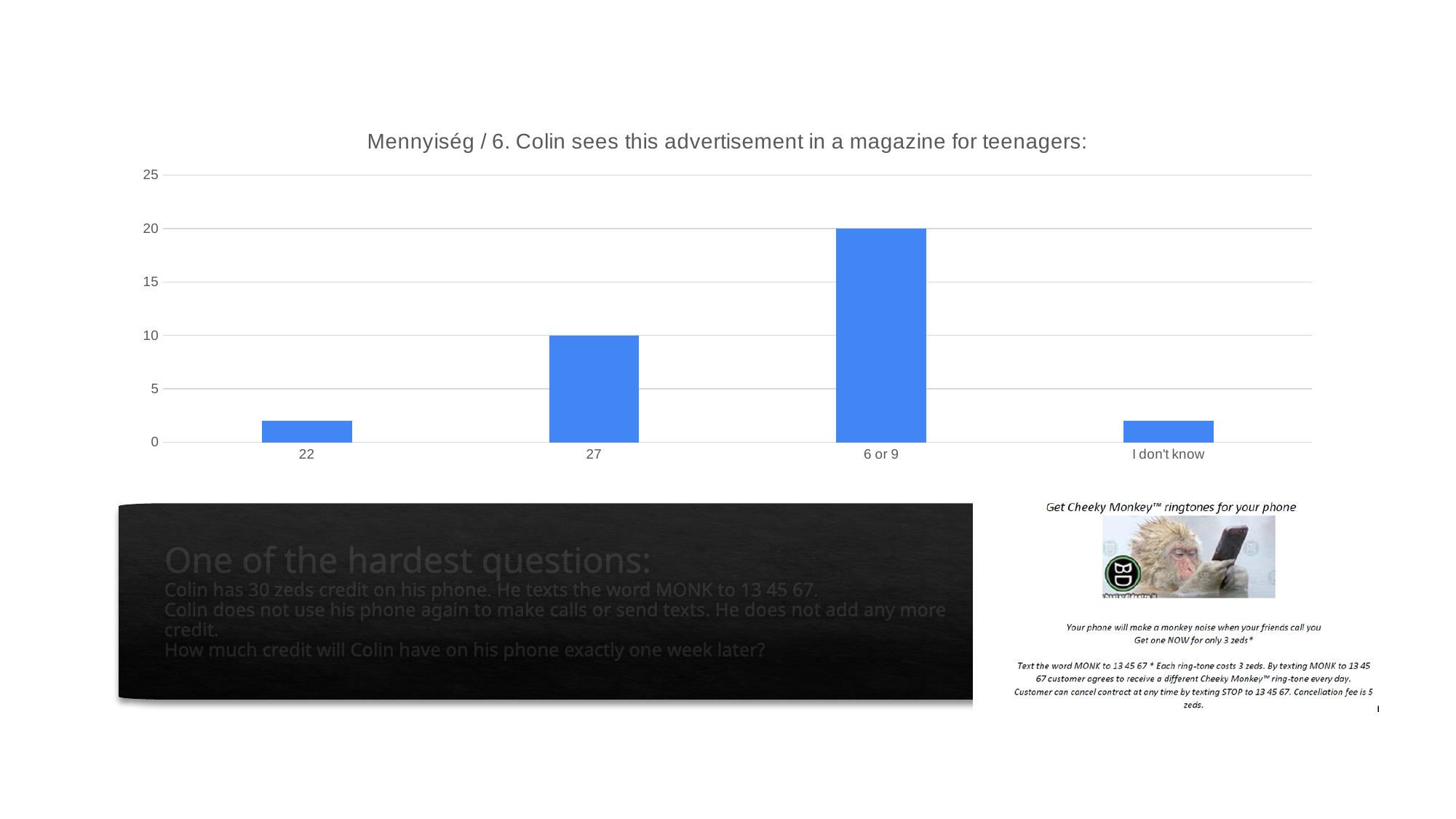
What is the value for the category "27"? 10 Which category has the highest value? 6 or 9 What kind of chart is shown on the slide? bar chart What is the title of the chart? Mennyiség / 6. Colin sees this advertisement in a magazine for teenagers: Which is larger, the value for "27" or the value for "6 or 9"? 6 or 9 Is the value for "6 or 9" greater or less than 15? greater What is the value for the category "6 or 9"? 20 What is the highest value shown on the vertical axis? 25 How many categories are shown on the x axis? 4 Is the value for "I don't know" greater or less than 5? less What is the difference between the values for "6 or 9" and "27"? 10 Is the value for "22" greater or less than 5? less